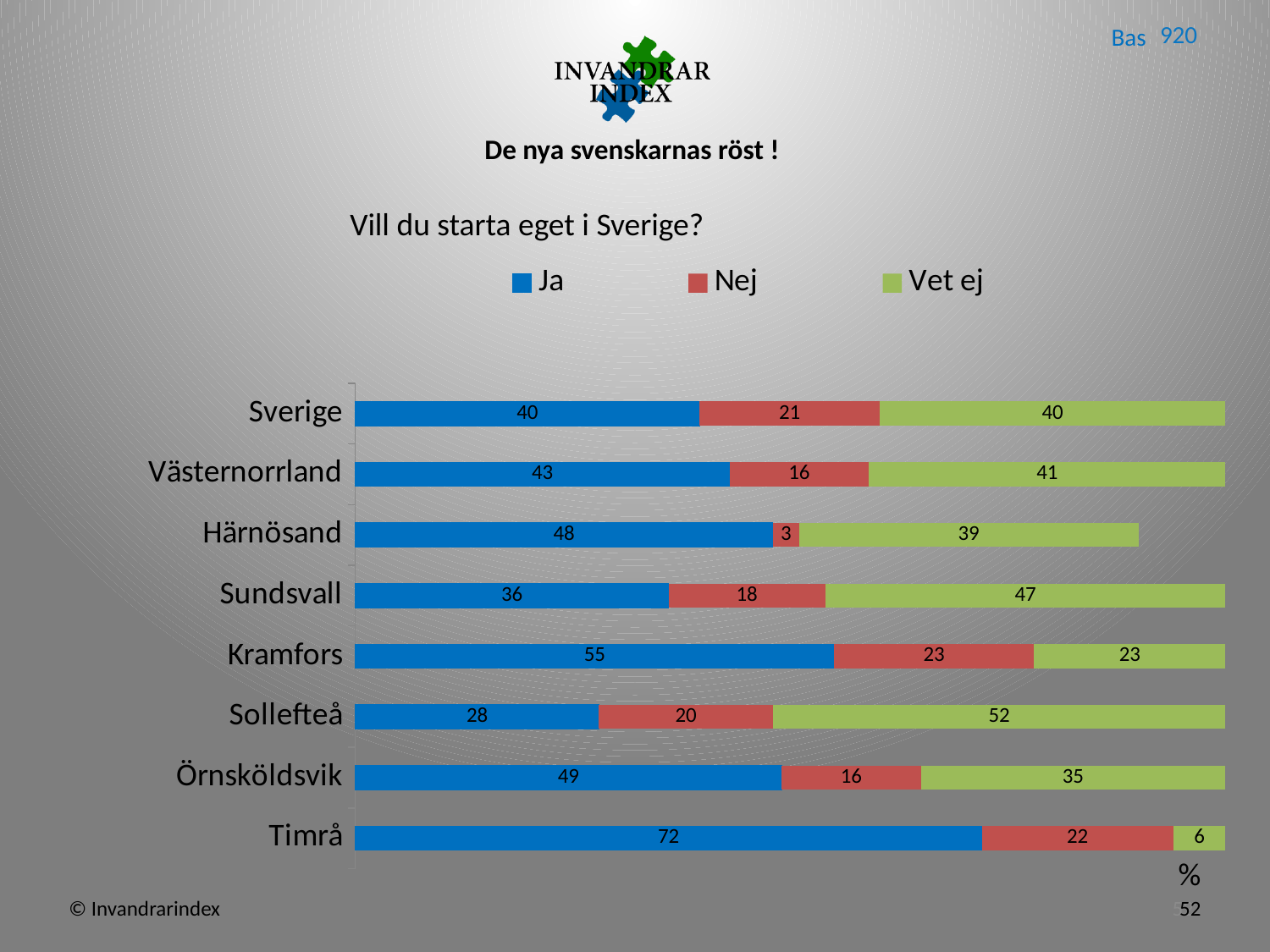
How many categories are shown on the chart? 8 What is the difference between the Ja values for Kramfors and Sollefteå? 27 Which category has the highest Ja value? Timrå What kind of chart is shown on the slide? Stacked bar chart Which is larger, the Vet ej value for Sundsvall or for Örnsköldsvik? Sundsvall What is the Nej value for Härnösand? 3 What is the title of the chart? Vill du starta eget i Sverige? What is the Vet ej value for Sollefteå? 52 What is the Ja value for Timrå? 72 What is the total of the stacked bar for Västernorrland? 100 Which category has the lowest Nej value? Härnösand How many series does the legend list? 3